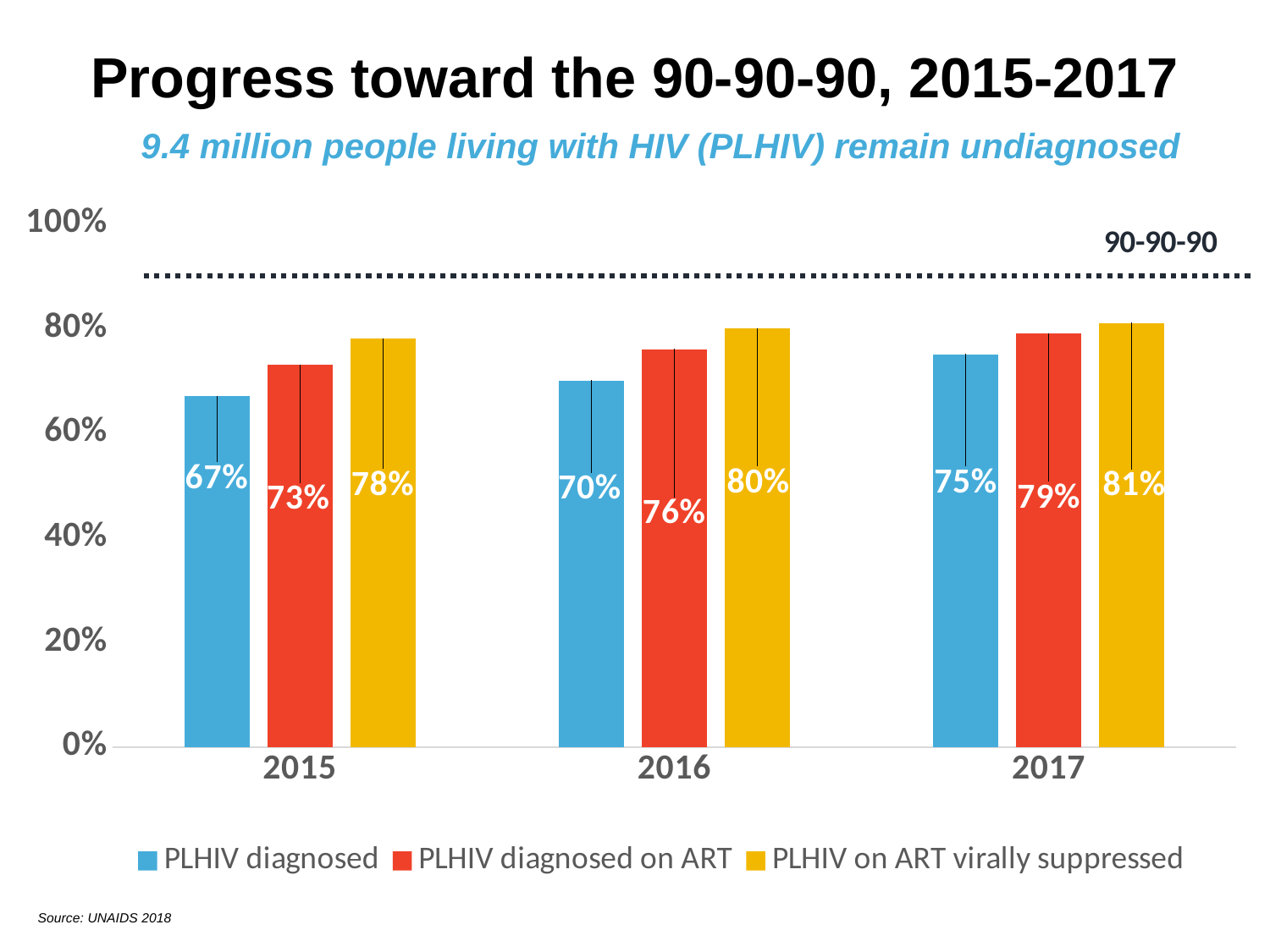
Does the value for PLHIV diagnosed on ART rise or fall from 2015 to 2017? Rise What kind of chart is shown on the slide? Bar chart In which year is the value for PLHIV diagnosed highest? 2017 How many series does the legend list? 3 Is the value for PLHIV on ART virally suppressed in 2016 greater or less than 60%? greater How many years are shown on the x axis? 3 In which year is the value for PLHIV on ART virally suppressed lowest? 2015 What is the value for PLHIV diagnosed on ART in 2016? 76% What is the difference between PLHIV diagnosed in 2017 and PLHIV diagnosed in 2015? 8% What is the value for PLHIV on ART virally suppressed in 2017? 81% Which is larger: PLHIV diagnosed on ART in 2015 or PLHIV diagnosed in 2016? PLHIV diagnosed on ART in 2015 What is the value for PLHIV diagnosed in 2015? 67%